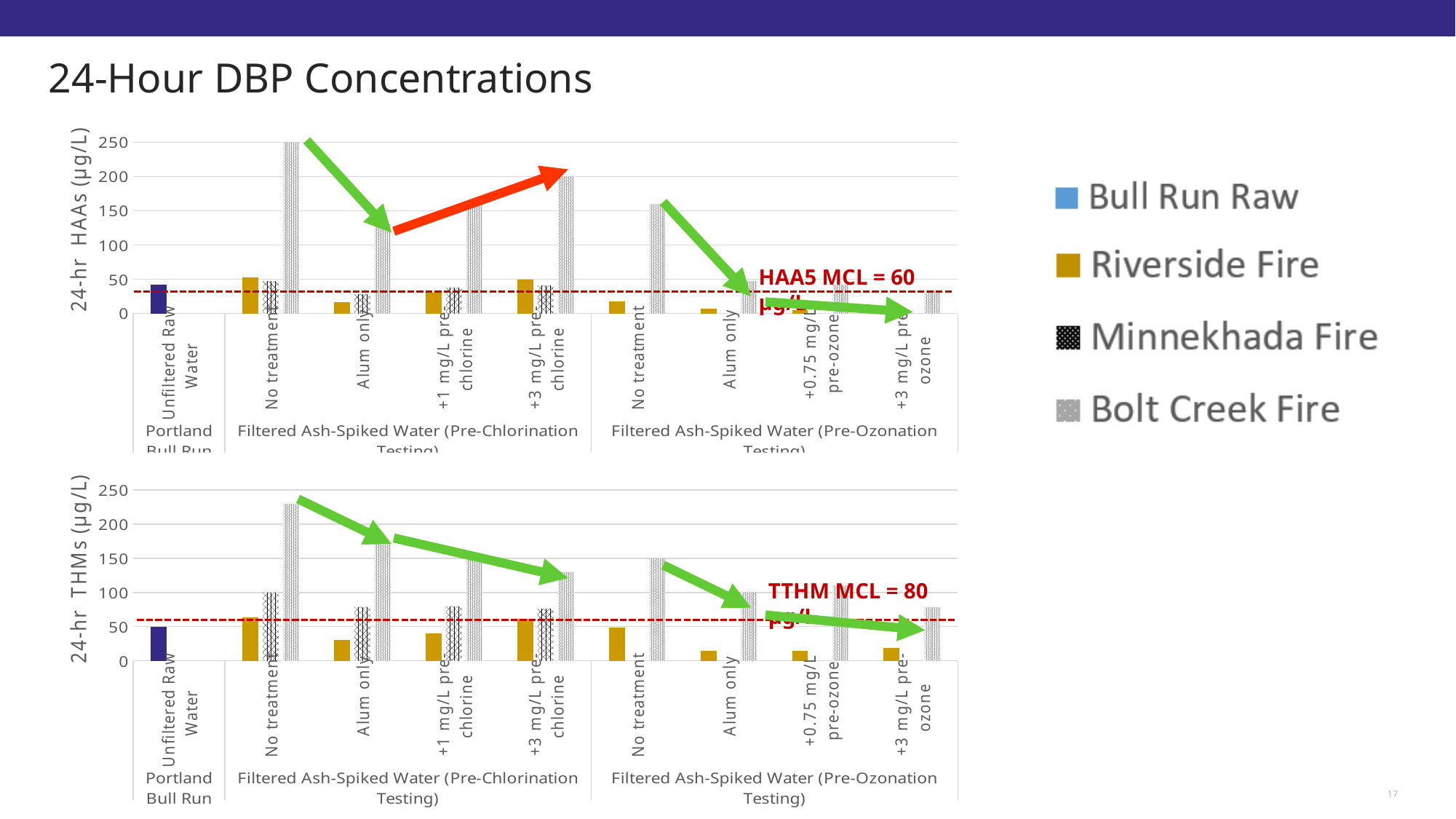
What kind of chart is the top chart (24-hr HAAs)? bar chart In the top chart (24-hr HAAs), which series has the highest bar overall? Bolt Creek Fire In the top chart (24-hr HAAs), is the Bolt Creek Fire value for 'No treatment' under Pre-Ozonation Testing greater or less than 150? greater In the top chart (24-hr HAAs), is the Riverside Fire value for 'Alum only' under Pre-Chlorination Testing greater or less than 50? less What TTHM MCL value is shown on the bottom chart? 80 µg/L In the bottom chart (24-hr THMs), is the Riverside Fire value for 'Alum only' under Pre-Chlorination Testing greater or less than 50? less In the top chart (24-hr HAAs), which is larger for Bolt Creek Fire: 'No treatment' under Pre-Chlorination Testing or 'No treatment' under Pre-Ozonation Testing? No treatment under Pre-Chlorination Testing What HAA5 MCL value is shown on the top chart? 60 µg/L How many series does the legend list? 4